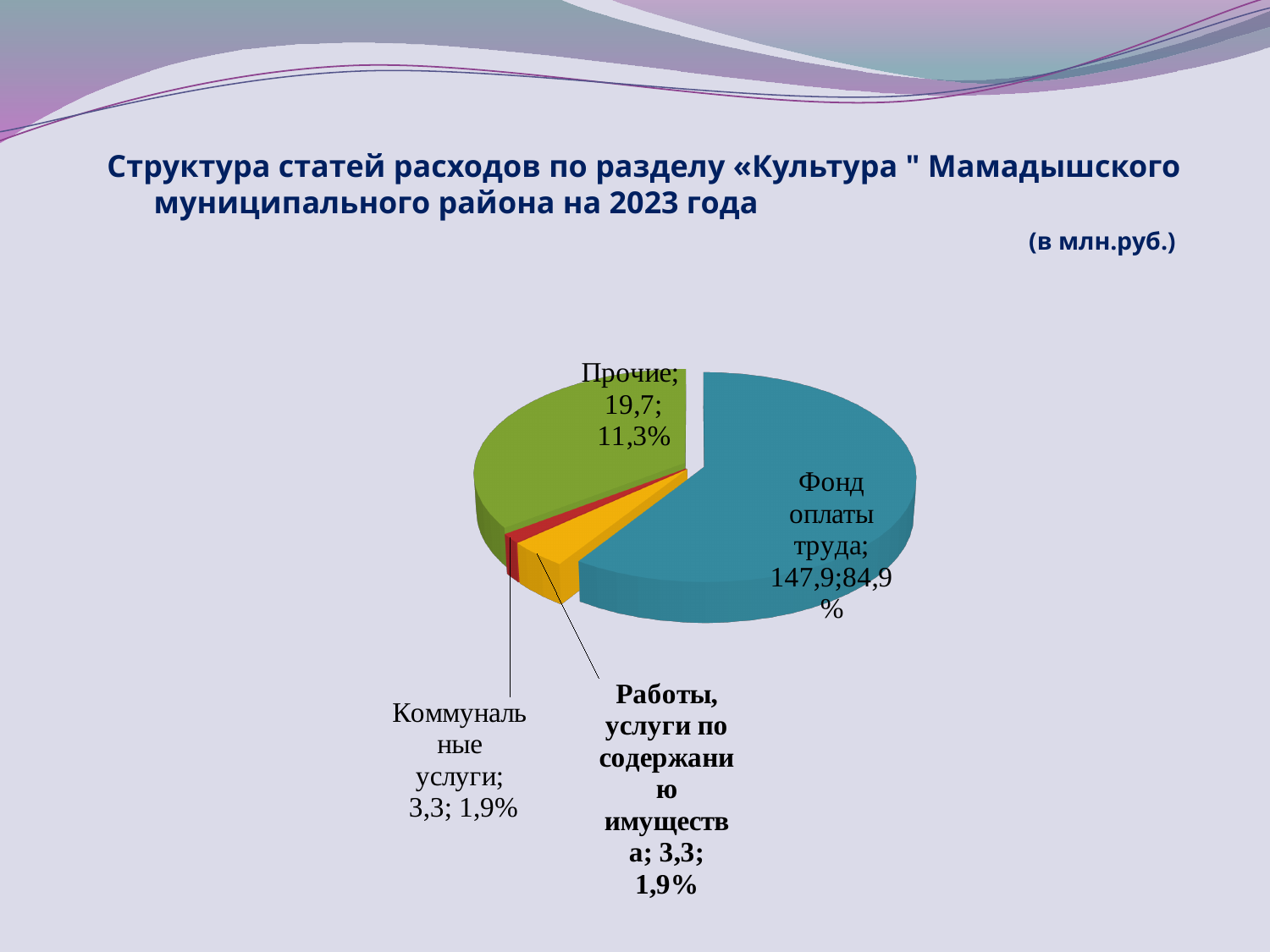
How many slices does the pie chart have? 4 Which category has the largest slice of the pie? Фонд оплаты труда What is the difference between the values for Фонд оплаты труда and Прочие? 128,2 What share of the pie does Работы, услуги по содержанию имущества represent? 1,9% What share of the pie does Прочие represent? 11,3% What is the value for Фонд оплаты труда? 147,9 What share of the pie does Фонд оплаты труда represent? 84,9% Which is larger, the value for Прочие or the value for Коммунальные услуги? Прочие What is the value for Коммунальные услуги? 3,3 What is the value for Прочие? 19,7 What kind of chart is shown on the slide? Pie chart In what units are the values on the chart given, according to the slide? млн.руб.